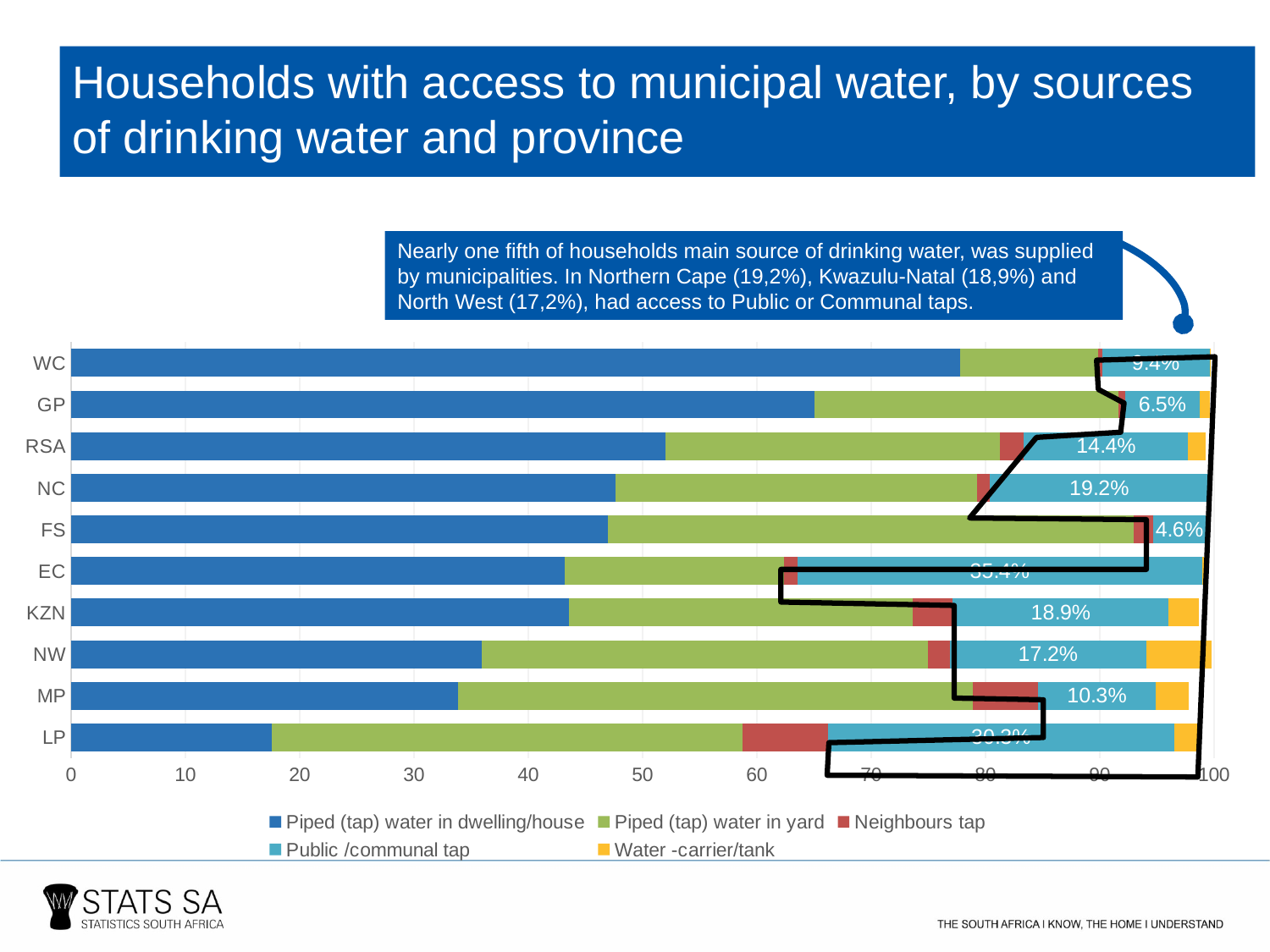
What is the labelled value for Public/communal tap for RSA? 14.4% What is the labelled value for Public/communal tap for MP? 10.3% How many provinces/categories are plotted on the vertical axis of the chart? 10 Which colour represents Neighbours tap in the legend? Red What is the difference between the Public/communal tap values for NC and FS? 14.6% What is the labelled value for Public/communal tap for GP? 6.5% Is the value for Piped (tap) water in dwelling/house for LP greater or less than 20? less What is the labelled value for Public/communal tap for NC? 19.2% What is the labelled value for Public/communal tap for KZN? 18.9% Which has a larger Public/communal tap share, NC or FS? NC How many series does the chart legend list? 5 What type of chart is shown on the slide? Stacked bar chart